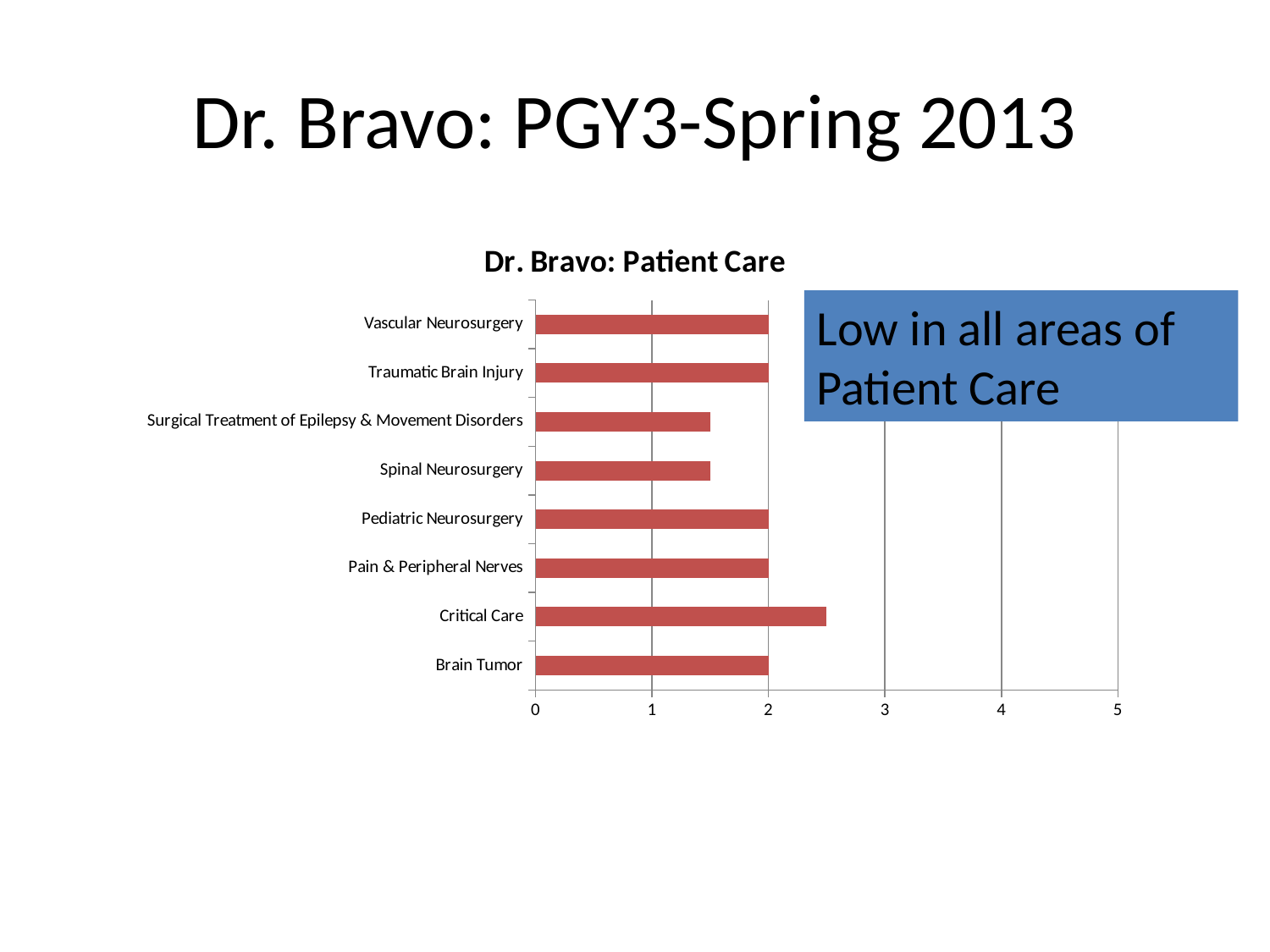
What is the title of the chart? Dr. Bravo: Patient Care What is the value for Vascular Neurosurgery? 2 What type of chart is shown on the slide? Bar chart Is the value for Surgical Treatment of Epilepsy & Movement Disorders greater or less than 1? greater Which category has the highest value in the chart? Critical Care Which is larger, the value for Critical Care or the value for Traumatic Brain Injury? Critical Care Is the value for Spinal Neurosurgery greater or less than 2? less What is the value for Brain Tumor? 2 What is the value for Pediatric Neurosurgery? 2 How many categories are plotted in the chart? 8 Is the value for Critical Care greater or less than 2? greater Which is larger, the value for Pain & Peripheral Nerves or the value for Spinal Neurosurgery? Pain & Peripheral Nerves